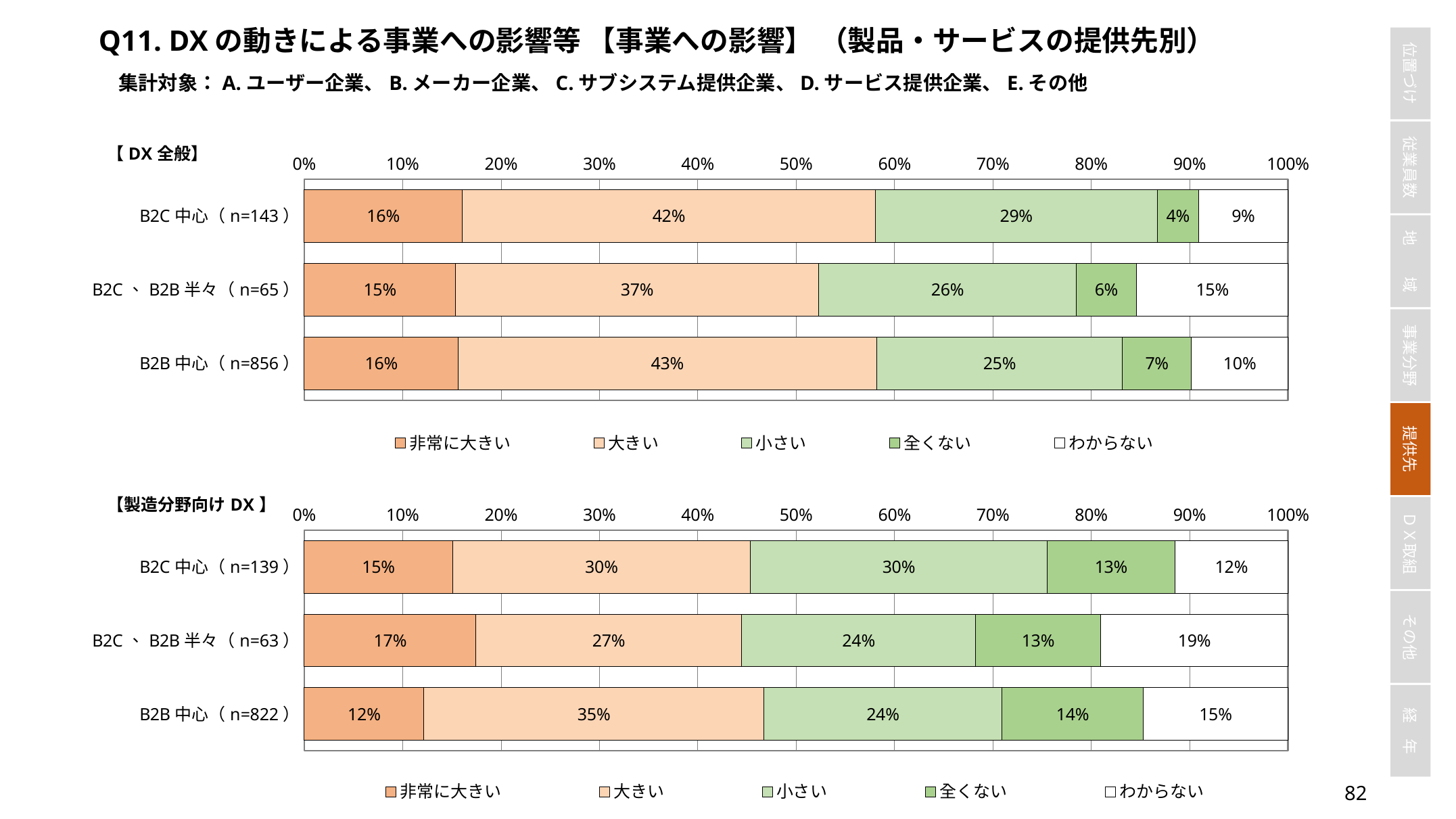
In the 【製造分野向けDX】 chart, which is larger: わからない for B2C、B2B半々（n=63） or わからない for B2C中心（n=139）? B2C、B2B半々（n=63） In the 【DX全般】 chart, what is the difference between the 大きい values for B2B中心（n=856） and B2C、B2B半々（n=65）? 6% How many series does the legend of the 【DX全般】 chart list? 5 In the 【製造分野向けDX】 chart, what is the value of 全くない for B2B中心（n=822）? 14% How many categories are shown in the 【製造分野向けDX】 chart? 3 In the 【製造分野向けDX】 chart, what is the value of 非常に大きい for B2C、B2B半々（n=63）? 17% In the 【DX全般】 chart, what is the value of わからない for B2C、B2B半々（n=65）? 15% In the 【DX全般】 chart, which category has the highest value for 小さい? B2C中心（n=143） In the 【製造分野向けDX】 chart, what is the combined share of 非常に大きい and 大きい for B2C中心（n=139）? 45% In the 【製造分野向けDX】 chart, which category has the lowest value for 非常に大きい? B2B中心（n=822） In the 【DX全般】 chart, what is the value of 大きい for B2B中心（n=856）? 43% What type of chart is the 【DX全般】 chart? Stacked bar chart